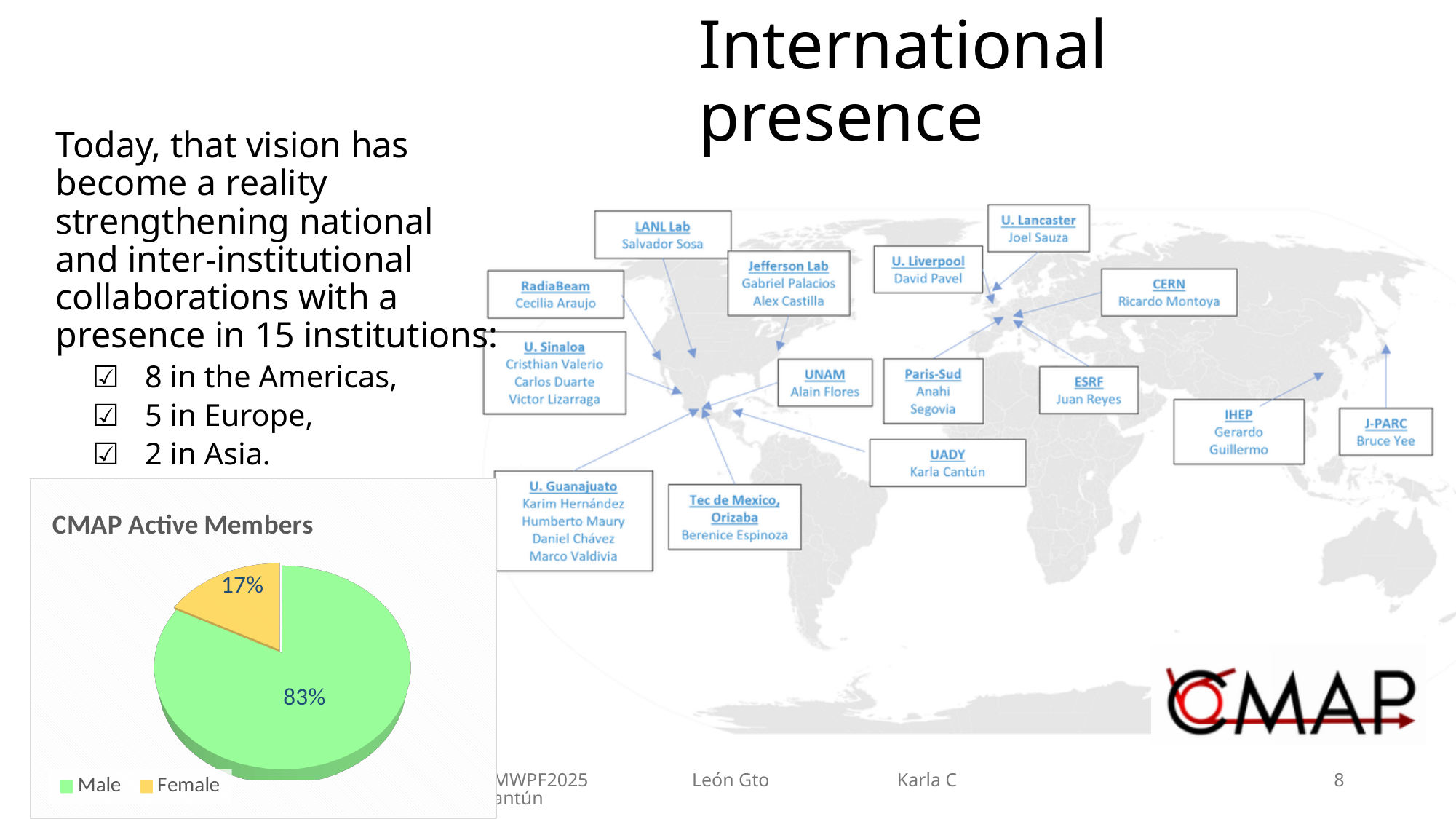
Which slice of the CMAP Active Members pie chart is the largest? Male Which slice of the CMAP Active Members pie chart is the smallest? Female What share of CMAP Active Members is Female? 17% How many slices does the CMAP Active Members pie chart have? 2 What is the title of the pie chart on the slide? CMAP Active Members What share of CMAP Active Members is Male? 83% What colour is the Female slice in the CMAP Active Members pie chart? yellow What kind of chart is "CMAP Active Members"? pie chart In the CMAP Active Members pie chart, which is larger, Male or Female? Male How many entries does the legend of the CMAP Active Members pie chart list? 2 What is the difference in percentage points between the Male and Female shares in the CMAP Active Members pie chart? 66